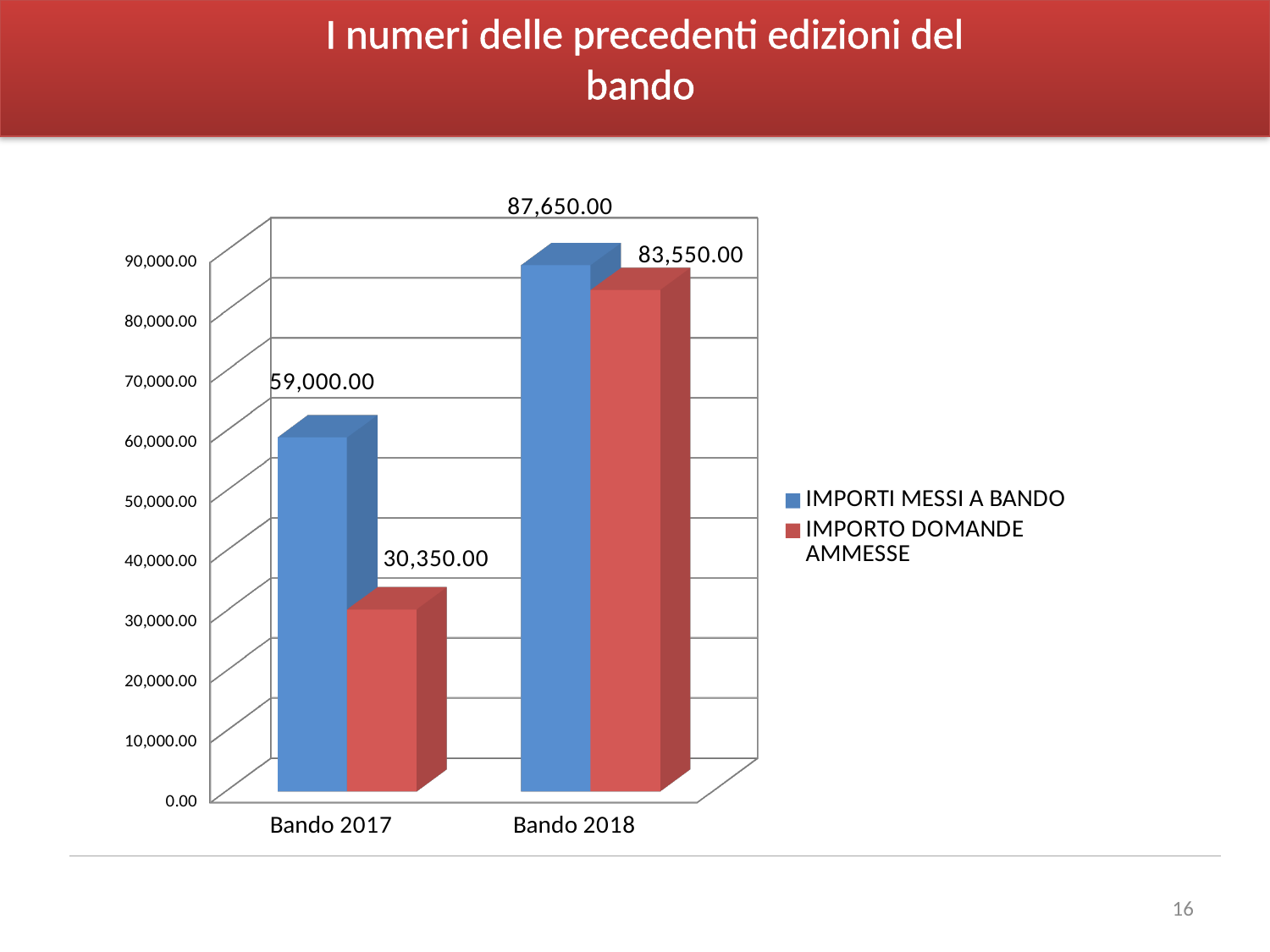
How many categories are shown on the x axis? 2 How many series does the legend list? 2 Which category has the lowest IMPORTO DOMANDE AMMESSE value? Bando 2017 What is the value of IMPORTI MESSI A BANDO for Bando 2017? 59,000.00 What is the value of IMPORTO DOMANDE AMMESSE for Bando 2018? 83,550.00 What kind of chart is shown on the slide? Bar chart Which is larger for Bando 2018: IMPORTI MESSI A BANDO or IMPORTO DOMANDE AMMESSE? IMPORTI MESSI A BANDO Which category has the highest IMPORTI MESSI A BANDO value? Bando 2018 What is the value of IMPORTI MESSI A BANDO for Bando 2018? 87,650.00 What is the difference between IMPORTI MESSI A BANDO and IMPORTO DOMANDE AMMESSE for Bando 2018? 4,100.00 What is the value of IMPORTO DOMANDE AMMESSE for Bando 2017? 30,350.00 What is the difference between IMPORTI MESSI A BANDO and IMPORTO DOMANDE AMMESSE for Bando 2017? 28,650.00